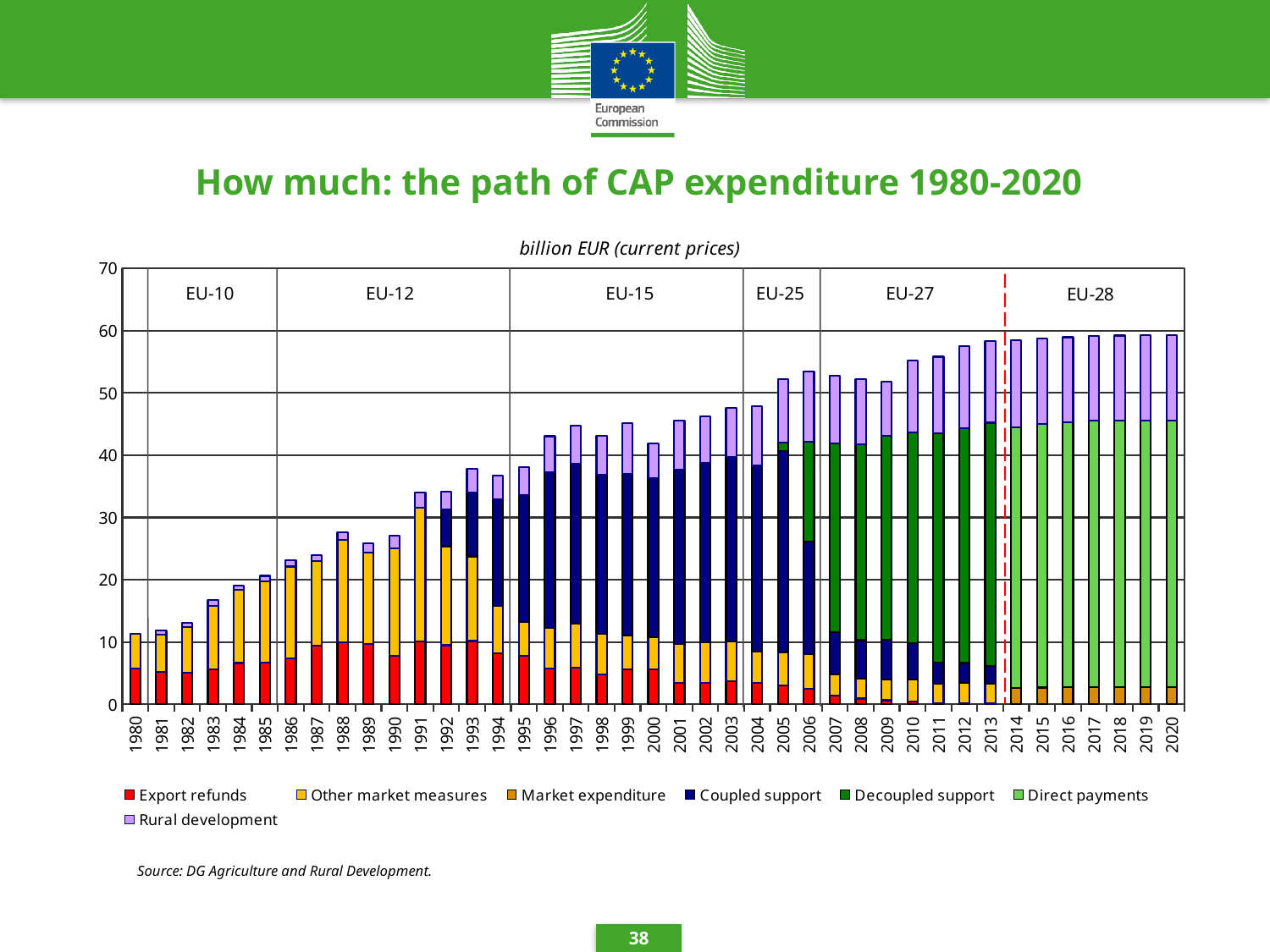
What unit is given above the chart for the values? billion EUR (current prices) Which year has the larger total CAP expenditure, 1980 or 2020? 2020 How many years (bars) are plotted along the x axis? 41 Which year has the larger total CAP expenditure, 1990 or 1991? 1991 Do the total bar heights generally rise or fall from 1980 to 2020? rise What kind of chart is shown on the slide? Stacked bar chart Is the total CAP expenditure for 2020 greater or less than 50 billion EUR? greater How many series does the legend list? 7 Which legend entry is shown in red? Export refunds Is the total CAP expenditure for 1980 greater or less than 20 billion EUR? less Is the total CAP expenditure for 1988 greater or less than 30 billion EUR? less